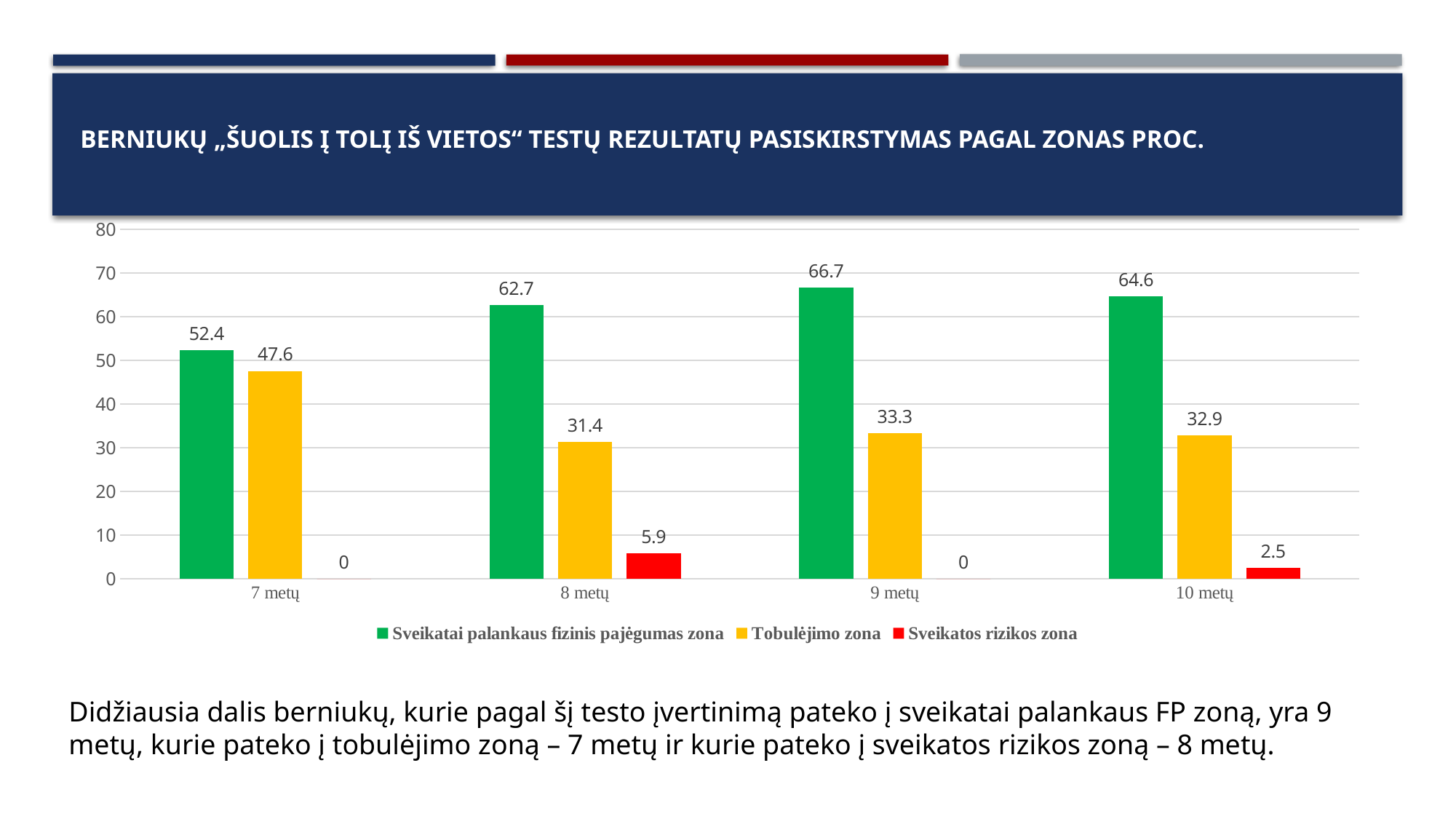
What kind of chart is shown on the slide? Bar chart What colour represents "Sveikatos rizikos zona" in the chart? Red Which age group has the lowest value for "Tobulėjimo zona"? 8 metų What is the value for "Sveikatai palankaus fizinis pajėgumas zona" at 9 metų? 66.7 How many age groups are shown on the x axis? 4 Which age group has the highest value for "Sveikatai palankaus fizinis pajėgumas zona"? 9 metų What is the value for "Sveikatos rizikos zona" at 8 metų? 5.9 What is the difference between the "Sveikatai palankaus fizinis pajėgumas zona" value and the "Tobulėjimo zona" value at 7 metų? 4.8 What is the value for "Tobulėjimo zona" at 7 metų? 47.6 How many series does the legend list? 3 Which is larger: the "Tobulėjimo zona" value at 9 metų or at 10 metų? 9 metų What is the value for "Sveikatos rizikos zona" at 10 metų? 2.5